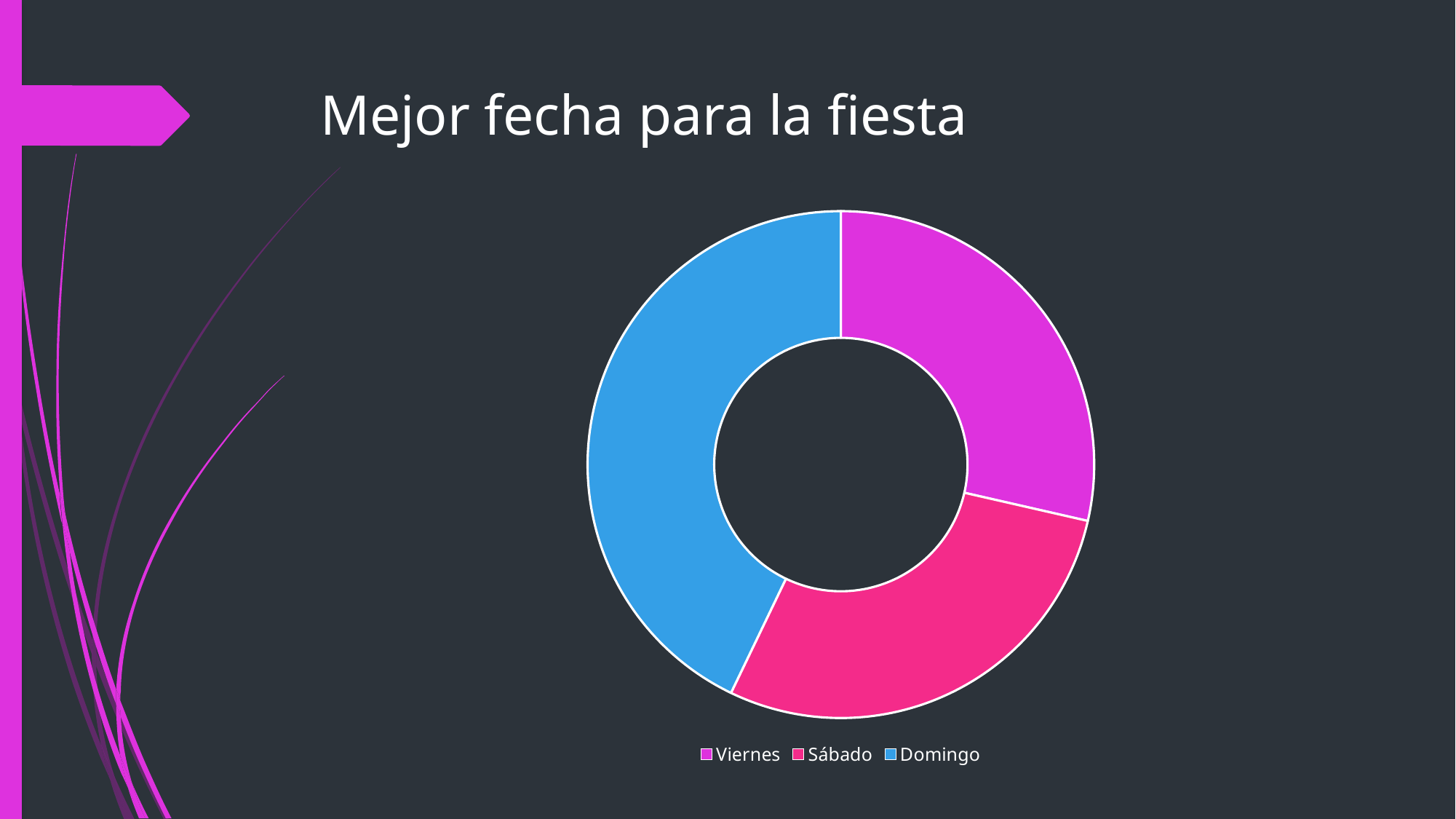
What colour is the Domingo slice in the chart? Blue How many categories does the chart show? 3 Which slice is larger, Domingo or Sábado? Domingo Which categories are listed in the legend of the chart? Viernes, Sábado, Domingo What is the title of the chart on the slide? Mejor fecha para la fiesta Which slice is larger, Domingo or Viernes? Domingo Which category has the largest slice in the chart? Domingo What kind of chart is shown on the slide? Doughnut chart How many entries does the legend list? 3